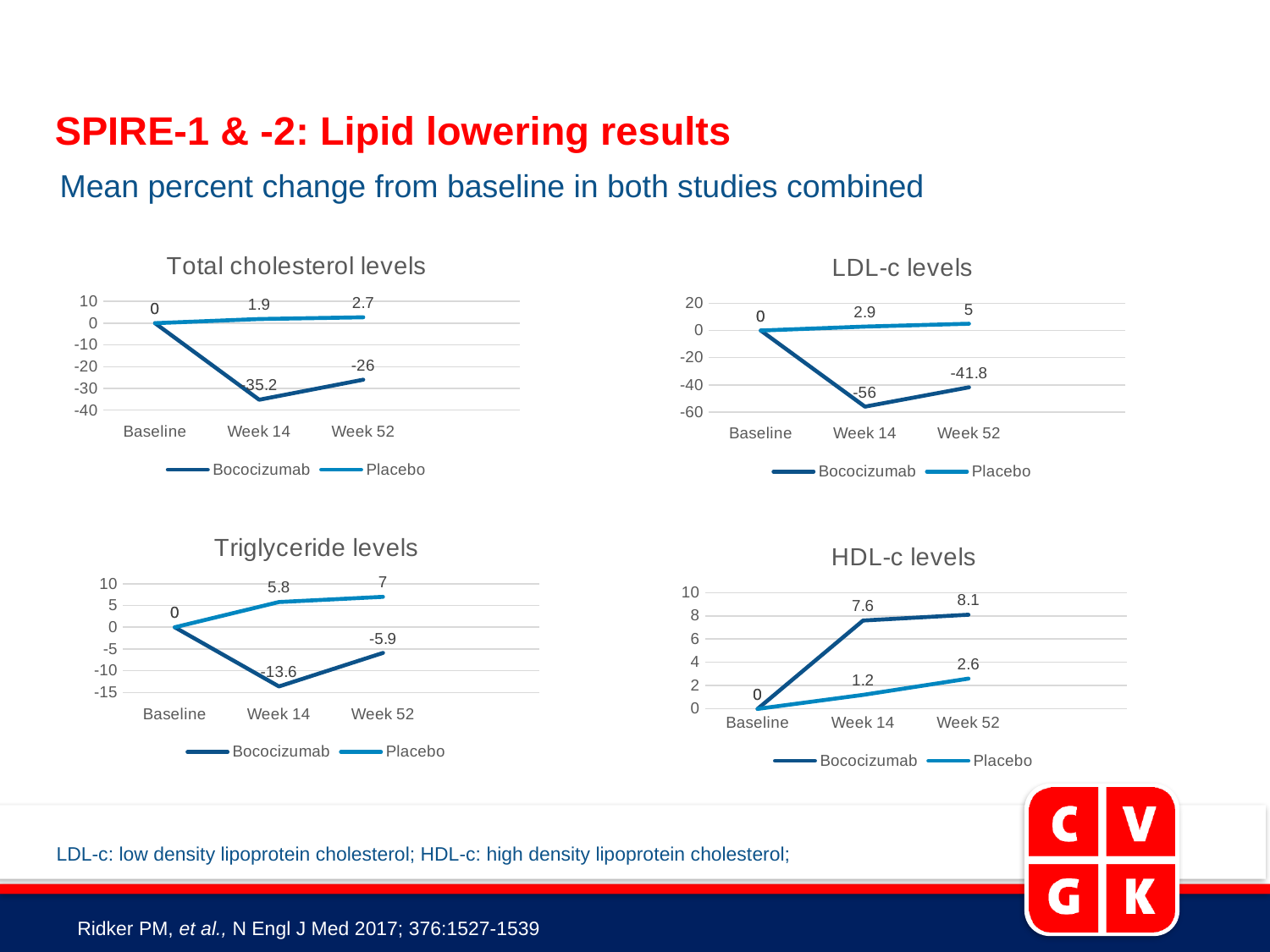
How many time points are shown on the x axis of the 'LDL-c levels' chart? 3 How many series does the legend of the 'HDL-c levels' chart list? 2 In the 'Total cholesterol levels' chart, at which time point is the Bococizumab value lowest? Week 14 In the 'LDL-c levels' chart, what is the value for Bococizumab at Week 14? -56 In the 'Triglyceride levels' chart, at which time point is the Placebo value highest? Week 52 In the 'LDL-c levels' chart, what is the difference between the Placebo and Bococizumab values at Week 52? 46.8 In the 'HDL-c levels' chart, what is the value for Bococizumab at Week 52? 8.1 What kind of chart is the 'Triglyceride levels' chart? Line chart In the 'Total cholesterol levels' chart, what is the value for Placebo at Week 52? 2.7 In the 'Triglyceride levels' chart, what is the value for Placebo at Week 14? 5.8 In the 'HDL-c levels' chart, which series has the higher value at Week 14, Bococizumab or Placebo? Bococizumab In the 'HDL-c levels' chart, does the Placebo series rise or fall from Baseline to Week 52? Rise